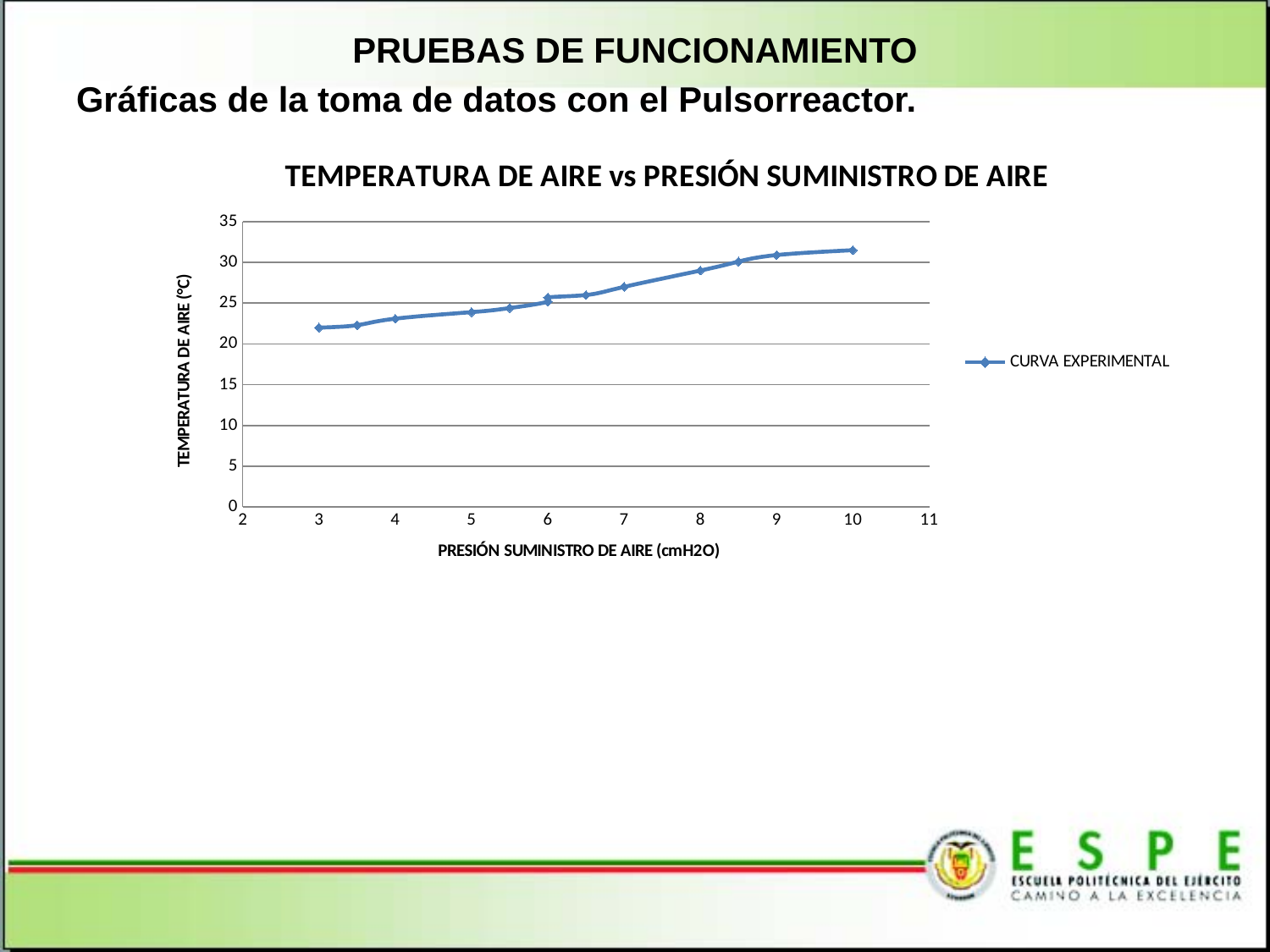
Does the air temperature rise or fall as the supply pressure increases along the x axis? Rises At which supply pressure is the air temperature highest? 10 At which supply pressure is the air temperature lowest? 3 What is the name of the series shown in the legend? CURVA EXPERIMENTAL How many series does the legend list? 1 What is the title of the chart? TEMPERATURA DE AIRE vs PRESIÓN SUMINISTRO DE AIRE How many data points are plotted on the CURVA EXPERIMENTAL line? 13 Is the temperature at a supply pressure of 3 cmH2O greater or less than 20? greater What kind of chart is shown on the slide? Line chart Is the temperature at a supply pressure of 4 cmH2O greater or less than 25? less Is the temperature at a supply pressure of 10 cmH2O greater or less than 30? greater Which has the higher temperature: a supply pressure of 5 cmH2O or 8 cmH2O? 8 cmH2O